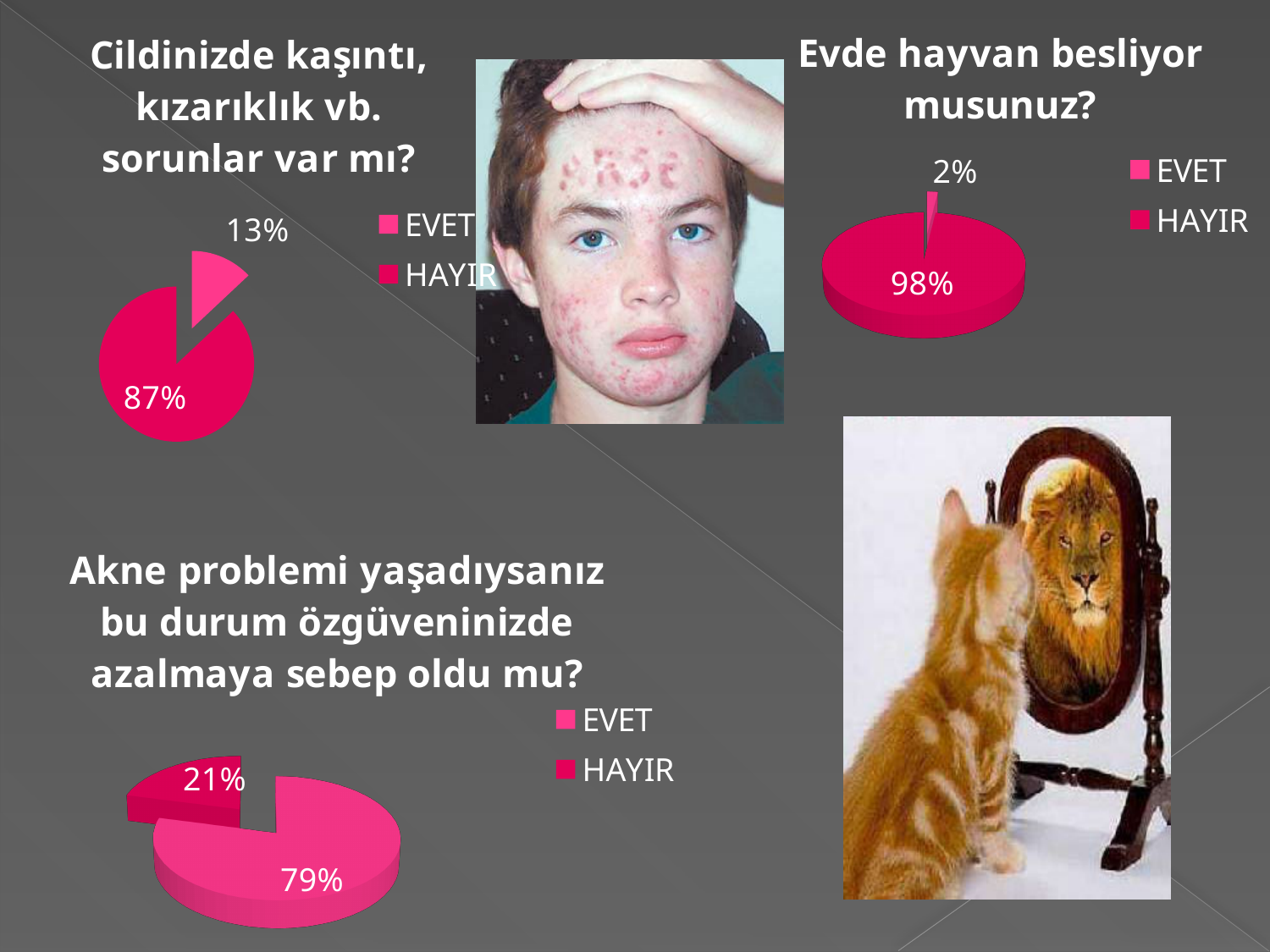
In the chart titled 'Cildinizde kaşıntı, kızarıklık vb. sorunlar var mı?', what is the difference between the HAYIR and EVET shares? 74% What kind of chart is the one titled 'Evde hayvan besliyor musunuz?'? Pie chart In the chart titled 'Cildinizde kaşıntı, kızarıklık vb. sorunlar var mı?', what share is labelled for EVET? 13% In the chart titled 'Cildinizde kaşıntı, kızarıklık vb. sorunlar var mı?', what share is labelled for HAYIR? 87% In the chart titled 'Akne problemi yaşadıysanız bu durum özgüveninizde azalmaya sebep oldu mu?', what share is labelled for EVET? 79% In the chart titled 'Akne problemi yaşadıysanız bu durum özgüveninizde azalmaya sebep oldu mu?', which category has the smallest slice? HAYIR How many entries does the legend of the chart titled 'Akne problemi yaşadıysanız bu durum özgüveninizde azalmaya sebep oldu mu?' list? 2 In the chart titled 'Akne problemi yaşadıysanız bu durum özgüveninizde azalmaya sebep oldu mu?', what share is labelled for HAYIR? 21% In the chart titled 'Evde hayvan besliyor musunuz?', what share is labelled for EVET? 2% How many pie charts are shown on the slide? 3 In the chart titled 'Evde hayvan besliyor musunuz?', which category has the largest slice? HAYIR In the chart titled 'Evde hayvan besliyor musunuz?', what share is labelled for HAYIR? 98%